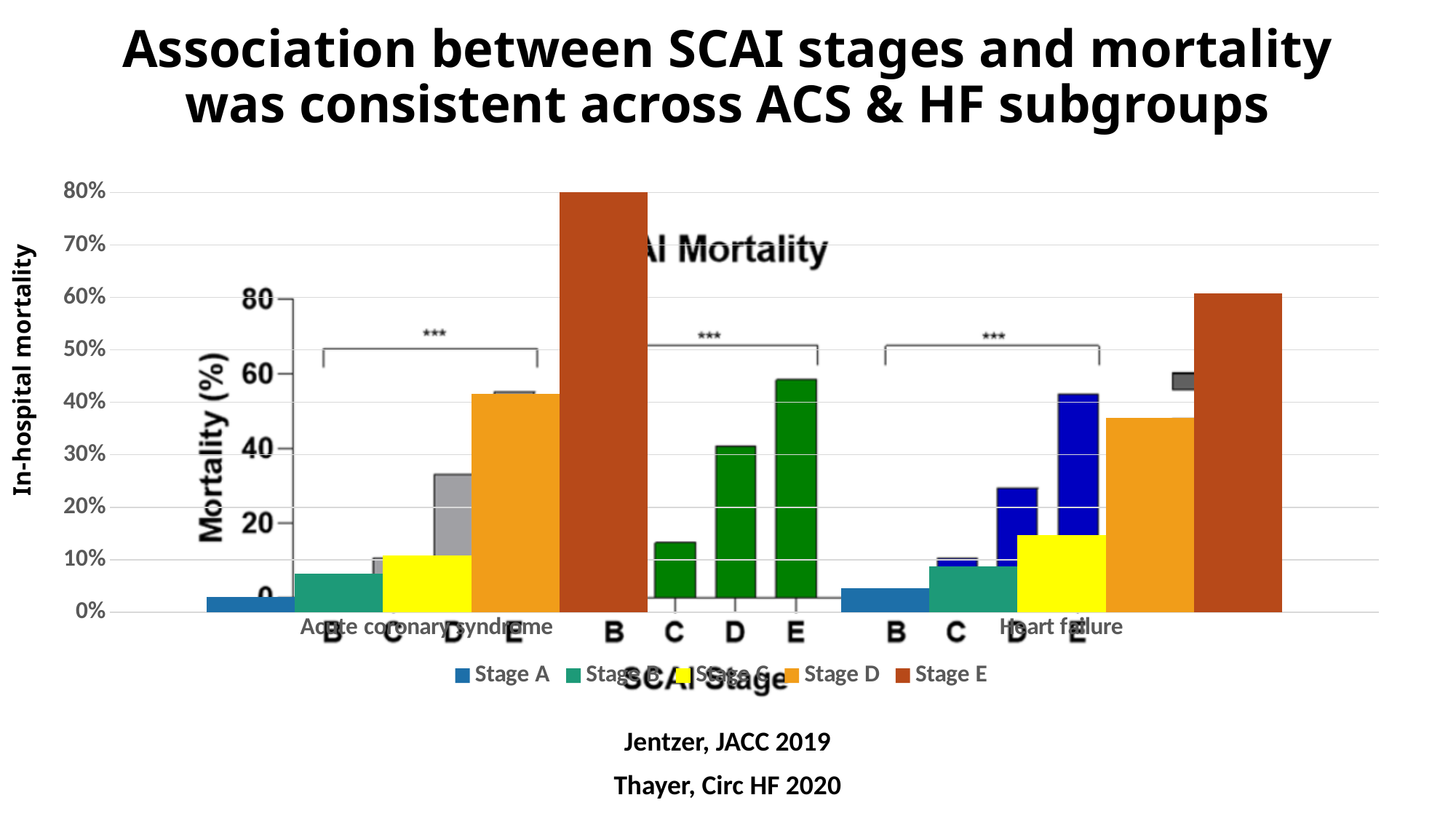
Which group has the higher Stage E in-hospital mortality, Acute coronary syndrome or Heart failure? Acute coronary syndrome Which stage has the lowest in-hospital mortality in the Heart failure group? Stage A What is the label of the vertical axis? In-hospital mortality Is the in-hospital mortality for Stage E in the Acute coronary syndrome group greater or less than 70%? greater What kind of chart is shown on the slide? Bar chart Which stage has the highest in-hospital mortality in the Acute coronary syndrome group? Stage E Within each subgroup, does in-hospital mortality rise or fall from Stage A to Stage E? Rise Is the in-hospital mortality for Stage D in the Acute coronary syndrome group greater or less than 30%? greater How many series does the legend list? 5 Is the in-hospital mortality for Stage E in the Heart failure group greater or less than 50%? greater How many subgroup categories are shown on the x axis? 2